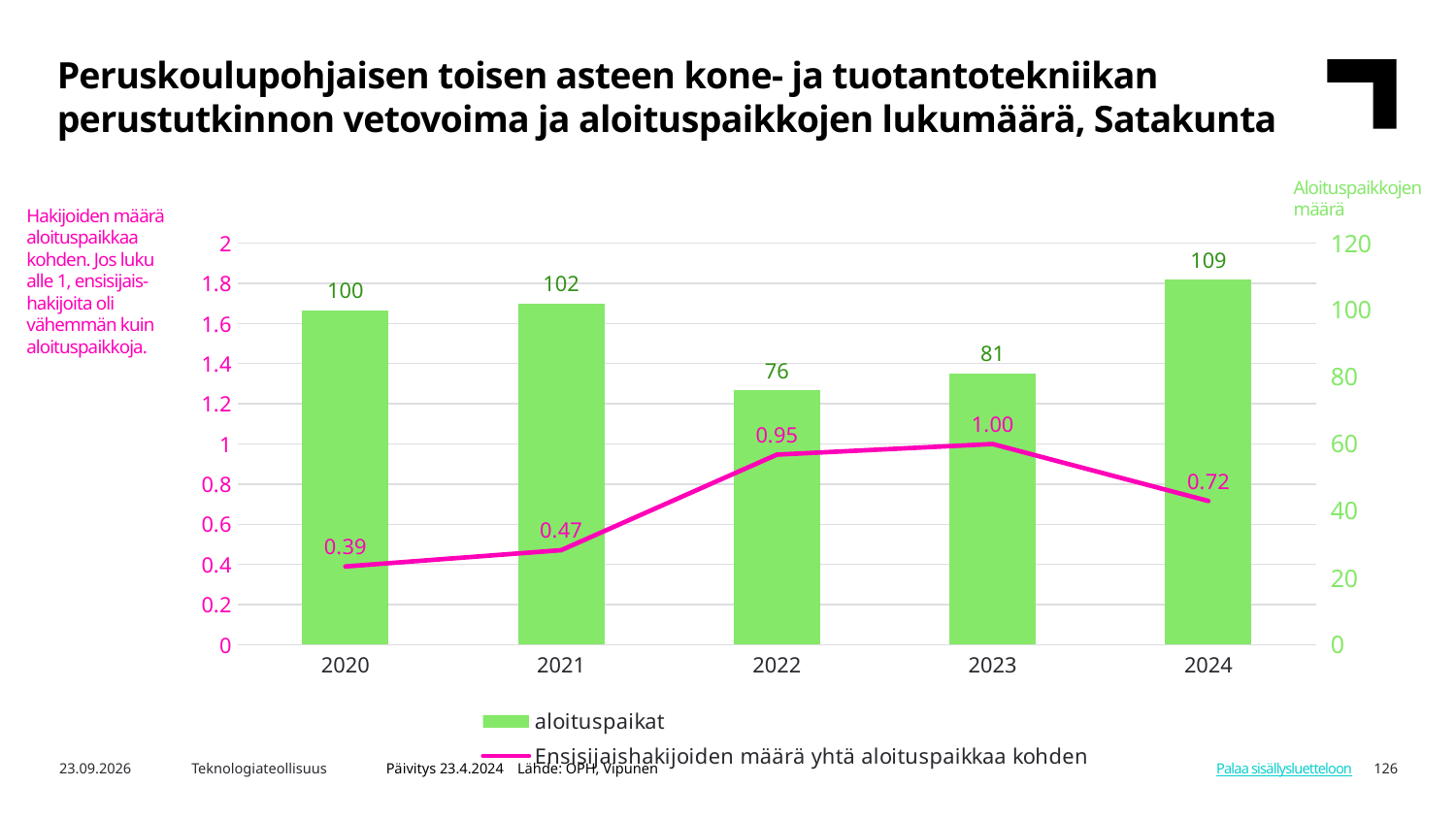
Does the Ensisijaishakijoiden määrä yhtä aloituspaikkaa kohden line rise or fall from 2023 to 2024? Fall How many years are shown on the x axis? 5 What is the difference in aloituspaikat between 2024 and 2022? 33 What is the value of aloituspaikat for 2022? 76 What kinds of chart are combined on this slide? Bar chart and line chart How many series does the legend list? 2 Which year has more aloituspaikat, 2021 or 2023? 2021 Which year has the lowest value of Ensisijaishakijoiden määrä yhtä aloituspaikkaa kohden? 2020 What is the value of aloituspaikat for 2024? 109 Which year has the highest value of aloituspaikat? 2024 What colour are the aloituspaikat bars? Green What is the value of Ensisijaishakijoiden määrä yhtä aloituspaikkaa kohden for 2022? 0.95